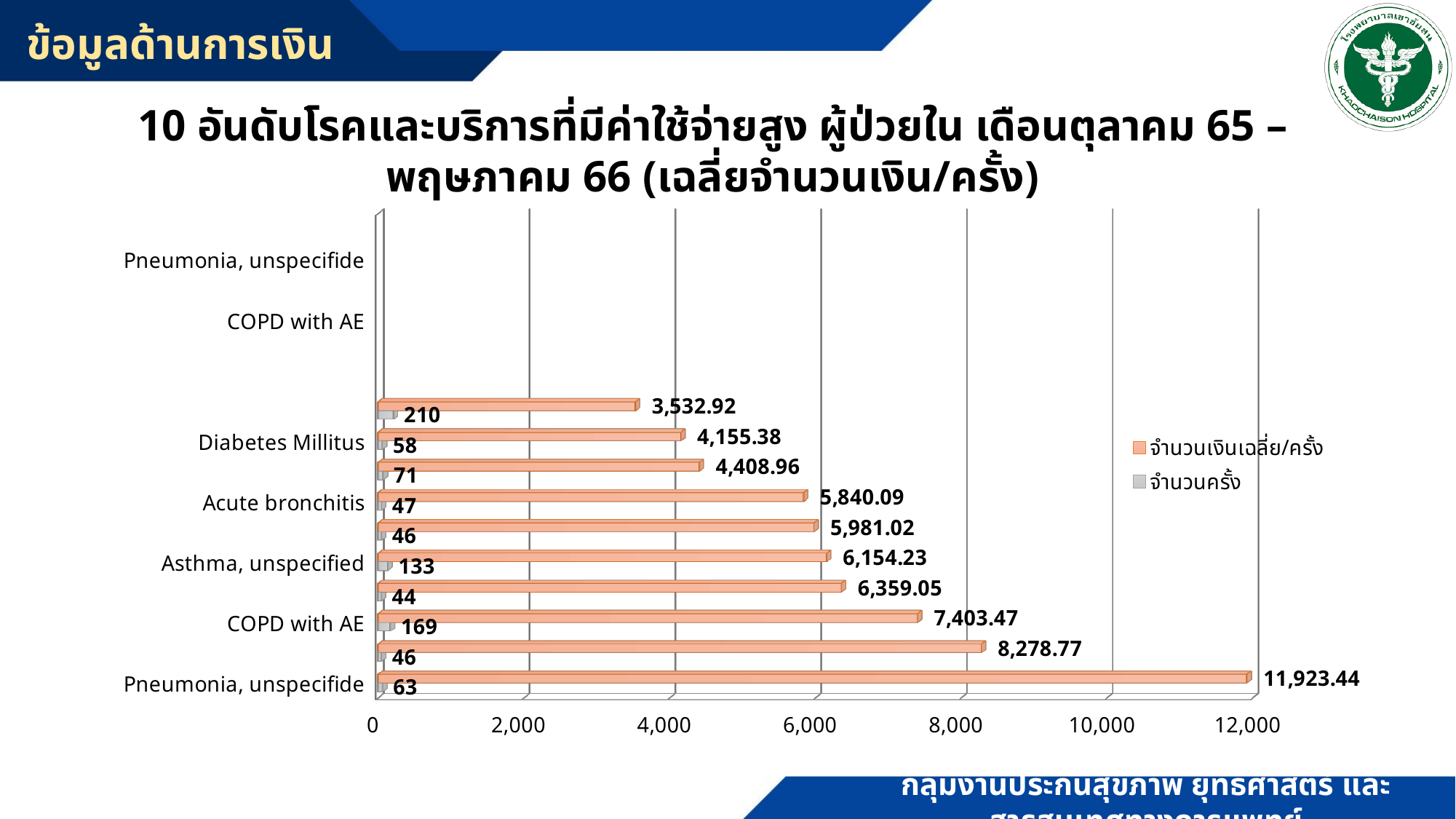
Which has a larger จำนวนเงินเฉลี่ย/ครั้ง value, Asthma, unspecified or Diabetes Millitus? Asthma, unspecified What is the lowest value shown for จำนวนเงินเฉลี่ย/ครั้ง? 3,532.92 What is the จำนวนครั้ง value for Asthma, unspecified? 133 What is the highest จำนวนครั้ง value shown on the chart? 210 What is the จำนวนเงินเฉลี่ย/ครั้ง value for Acute bronchitis? 5,840.09 What is the highest value shown for จำนวนเงินเฉลี่ย/ครั้ง? 11,923.44 What kind of chart is shown on the slide? bar chart What is the จำนวนเงินเฉลี่ย/ครั้ง value for Asthma, unspecified? 6,154.23 What is the difference between the จำนวนเงินเฉลี่ย/ครั้ง values for Asthma, unspecified and Acute bronchitis? 314.14 What is the จำนวนครั้ง value for Diabetes Millitus? 58 How many series does the chart legend list? 2 How many orange จำนวนเงินเฉลี่ย/ครั้ง bars are plotted on the chart? 10